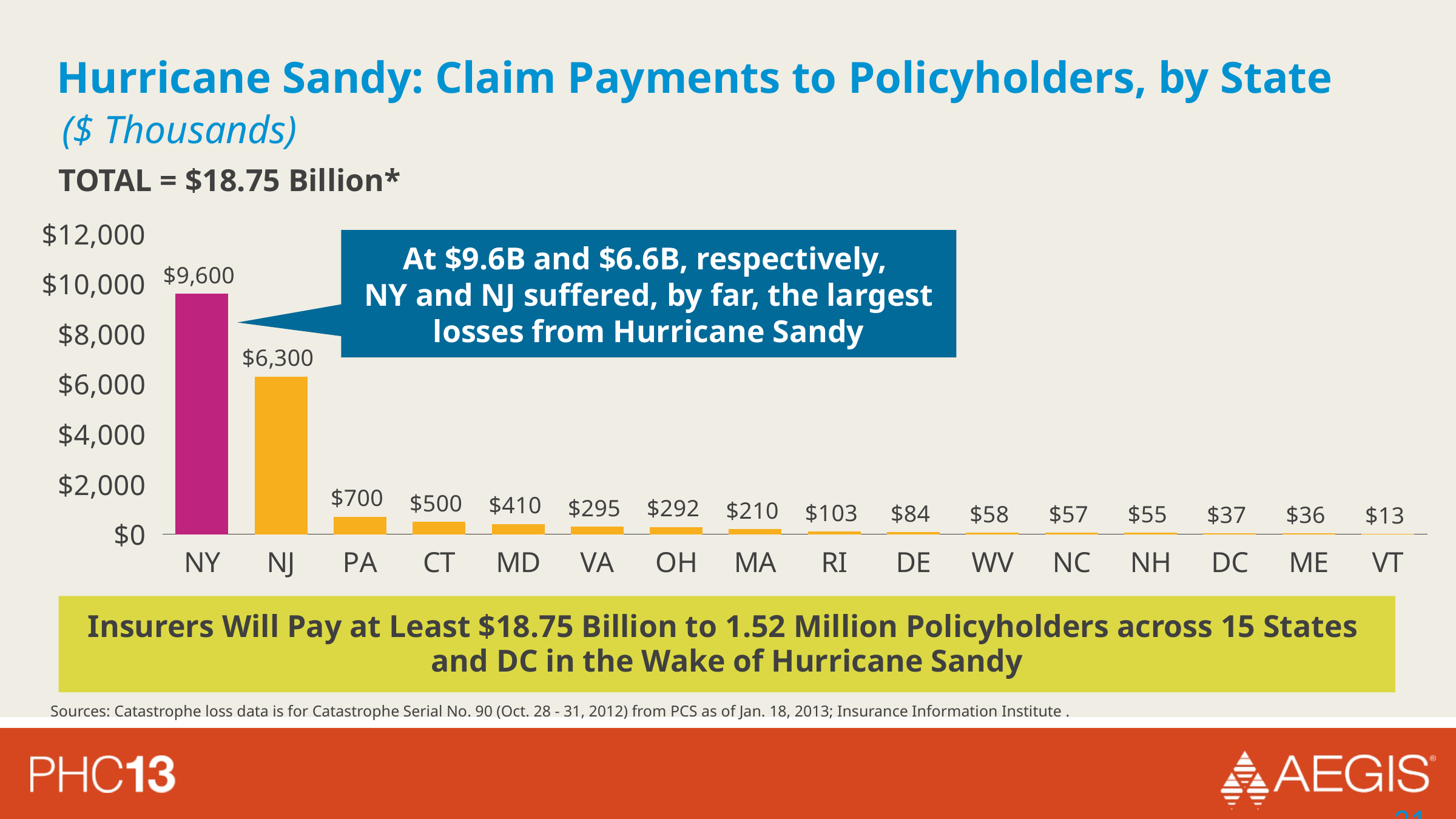
Which state has the highest claim payment value? NY What kind of chart is shown on the slide? bar chart Is the value for NJ greater or less than $8,000? less Which has a larger value, CT or MD? CT What is the claim payment value shown for NY? $9,600 How many states or jurisdictions are shown on the x axis? 16 Which state has the lowest claim payment value? VT Do the values rise or fall moving from left to right along the x axis? fall What is the claim payment value shown for VT? $13 What is the difference between the values for NY and NJ? $3,300 What is the claim payment value shown for PA? $700 What total is stated above the chart? $18.75 Billion